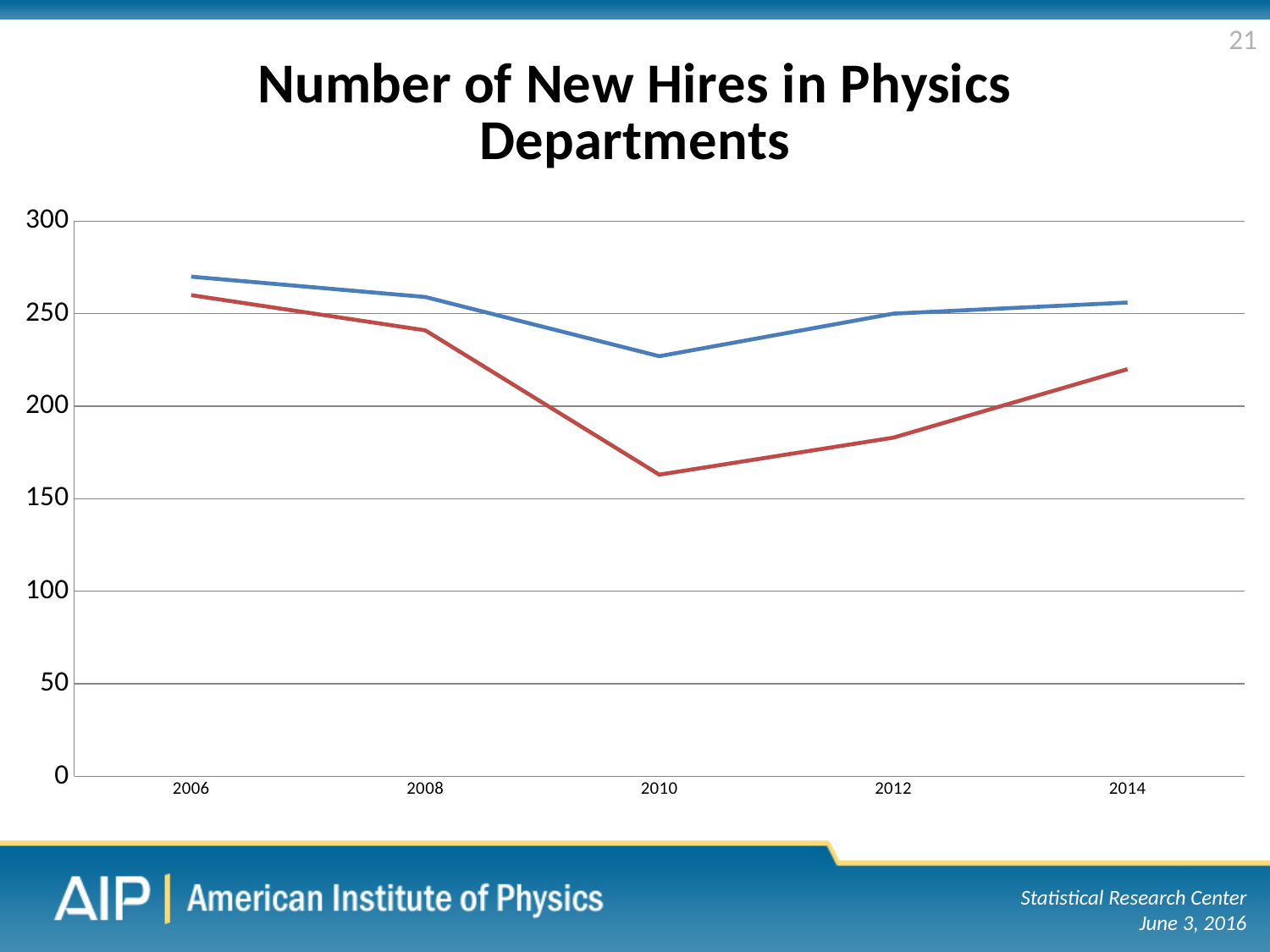
What kind of chart is shown on the slide? line chart How many lines are plotted on the chart? 2 Is the value of the blue line in 2010 greater or less than 200? greater In 2010, which line is higher, the blue line or the red line? blue Is the value of the blue line in 2006 greater or less than 250? greater What is the title of the chart? Number of New Hires in Physics Departments In which year is the blue line at its highest? 2006 In which year is the red line at its lowest? 2010 Is the value of the red line in 2014 greater or less than 250? less How many years are shown on the x axis of the chart? 5 Does the red line rise or fall from 2010 to 2014? rise